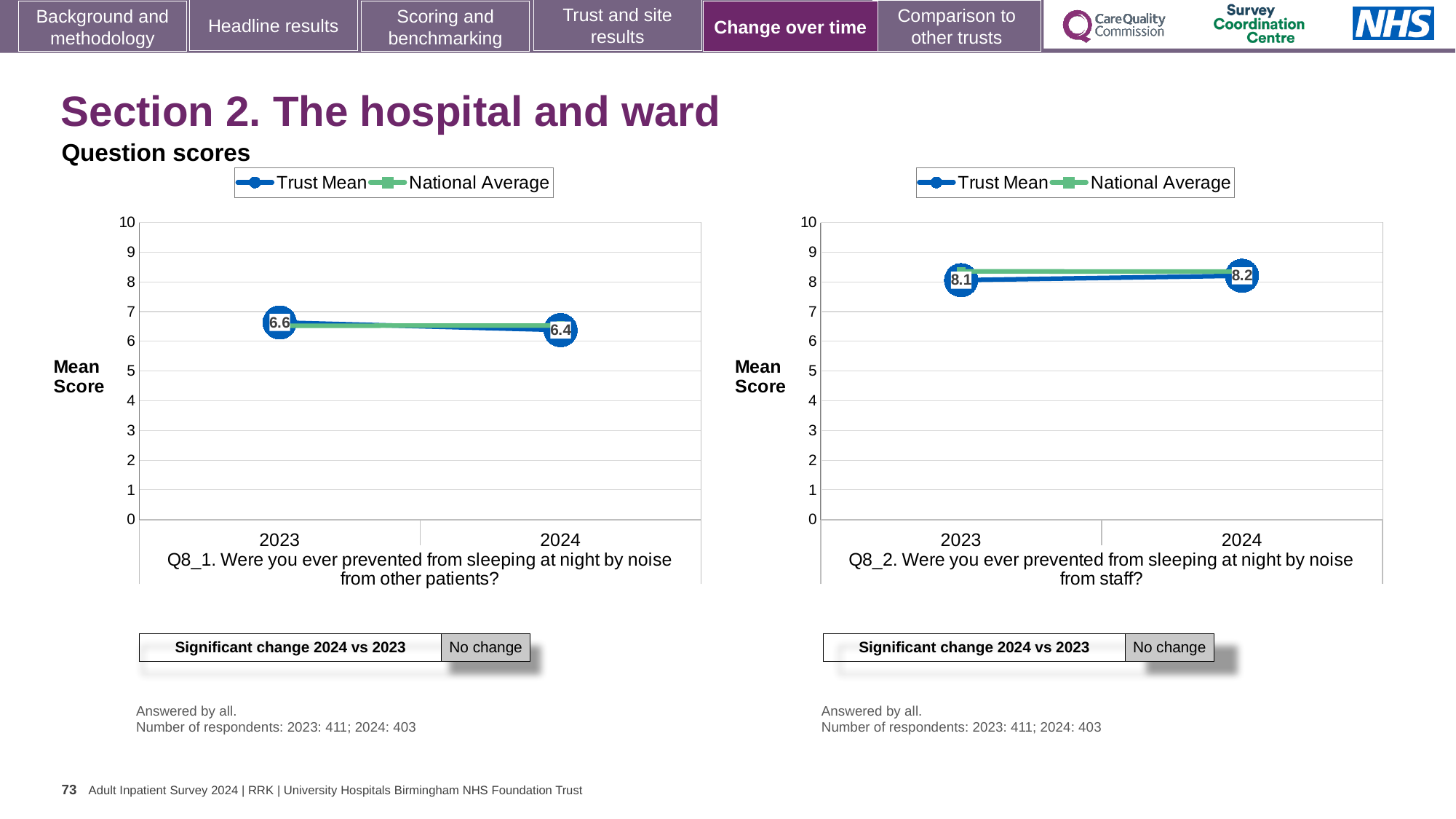
In the Q8_2 chart (right), what is the difference between the Trust Mean for 2024 and 2023? 0.1 In the Q8_1 chart (left), by how much did the Trust Mean change from 2023 to 2024? 0.2 In the Q8_2 chart (right), what is the Trust Mean for 2024? 8.2 In the Q8_2 chart (right), does the Trust Mean rise or fall from 2023 to 2024? rise In the Q8_2 chart (right), is the Trust Mean for 2023 greater or less than 7? greater In the Q8_1 chart (left), does the Trust Mean rise or fall from 2023 to 2024? fall How many years are shown on the x axis of the Q8_1 chart (left)? 2 What kind of chart is the Q8_1 chart on the left? line chart In the Q8_1 chart (left), what is the Trust Mean for 2023? 6.6 In the Q8_1 chart (left), what is the Trust Mean for 2024? 6.4 In the Q8_2 chart (right), what is the Trust Mean for 2023? 8.1 How many series does the legend of the Q8_2 chart (right) list? 2